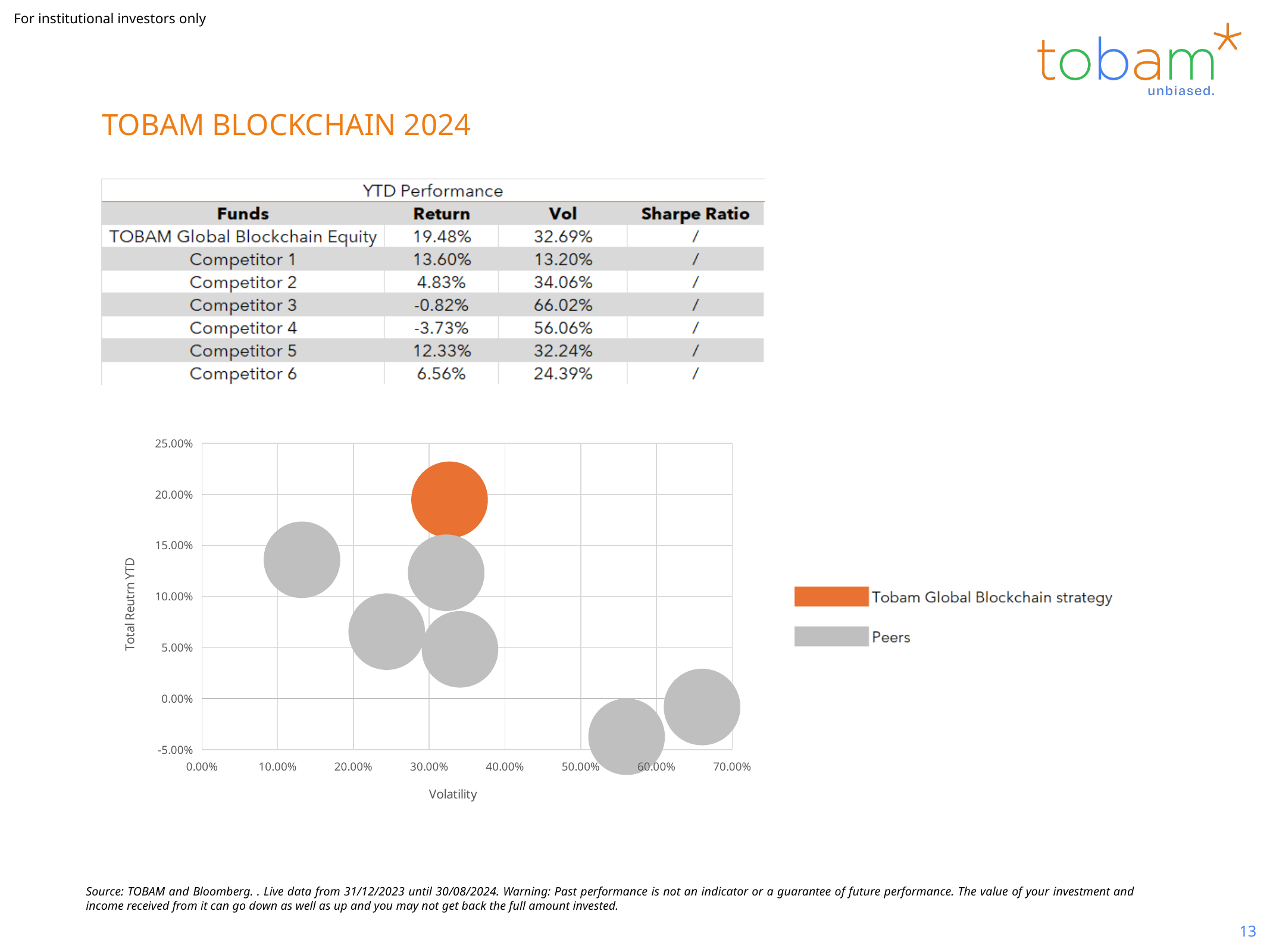
Is the Total Return YTD of the lowest grey bubble greater or less than 0.00%? less Which series has the bubble with the highest Total Return YTD on the chart? Tobam Global Blockchain strategy How many series does the chart legend list? 2 What is the title of the chart's horizontal axis? Volatility According to the YTD Performance table above the chart, what is the Return of TOBAM Global Blockchain Equity? 19.48% What is the title of the chart's vertical axis? Total Reutrn YTD Which series is shown in orange on the chart? Tobam Global Blockchain strategy How many bubbles are plotted on the chart? 7 What kind of chart is shown on the slide? Bubble chart Is the Volatility of the rightmost grey bubble greater or less than 60.00%? greater Is the Volatility of the leftmost grey bubble greater or less than 20.00%? less